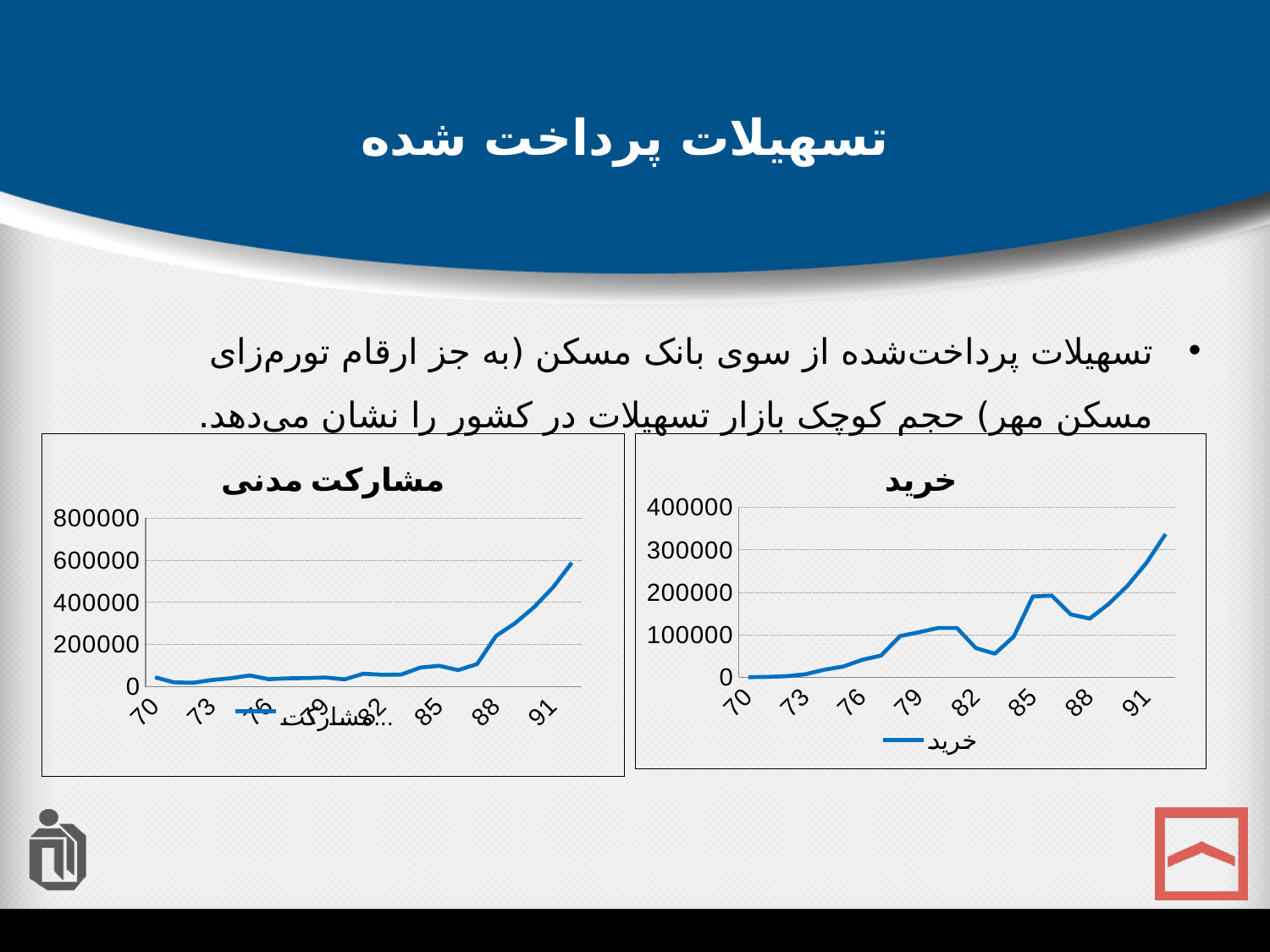
What is the highest value shown on the y axis of the chart titled "مشارکت مدنی"? 800000 What kind of chart is the chart titled "خرید"? line chart What kind of chart is the chart titled "مشارکت مدنی"? line chart In the chart titled "خرید", do the values generally rise or fall from 70 to 91? rise In the chart titled "مشارکت مدنی", do the values generally rise or fall from 85 to 91? rise In the chart titled "مشارکت مدنی", is the value for 91 greater or less than 200000? greater In the chart titled "خرید", is the value for 88 greater or less than 200000? less In the chart titled "خرید", is the value for 91 greater or less than 200000? greater How many series does the legend of the chart titled "خرید" list? 1 What is the title of the chart on the right side of the slide? خرید